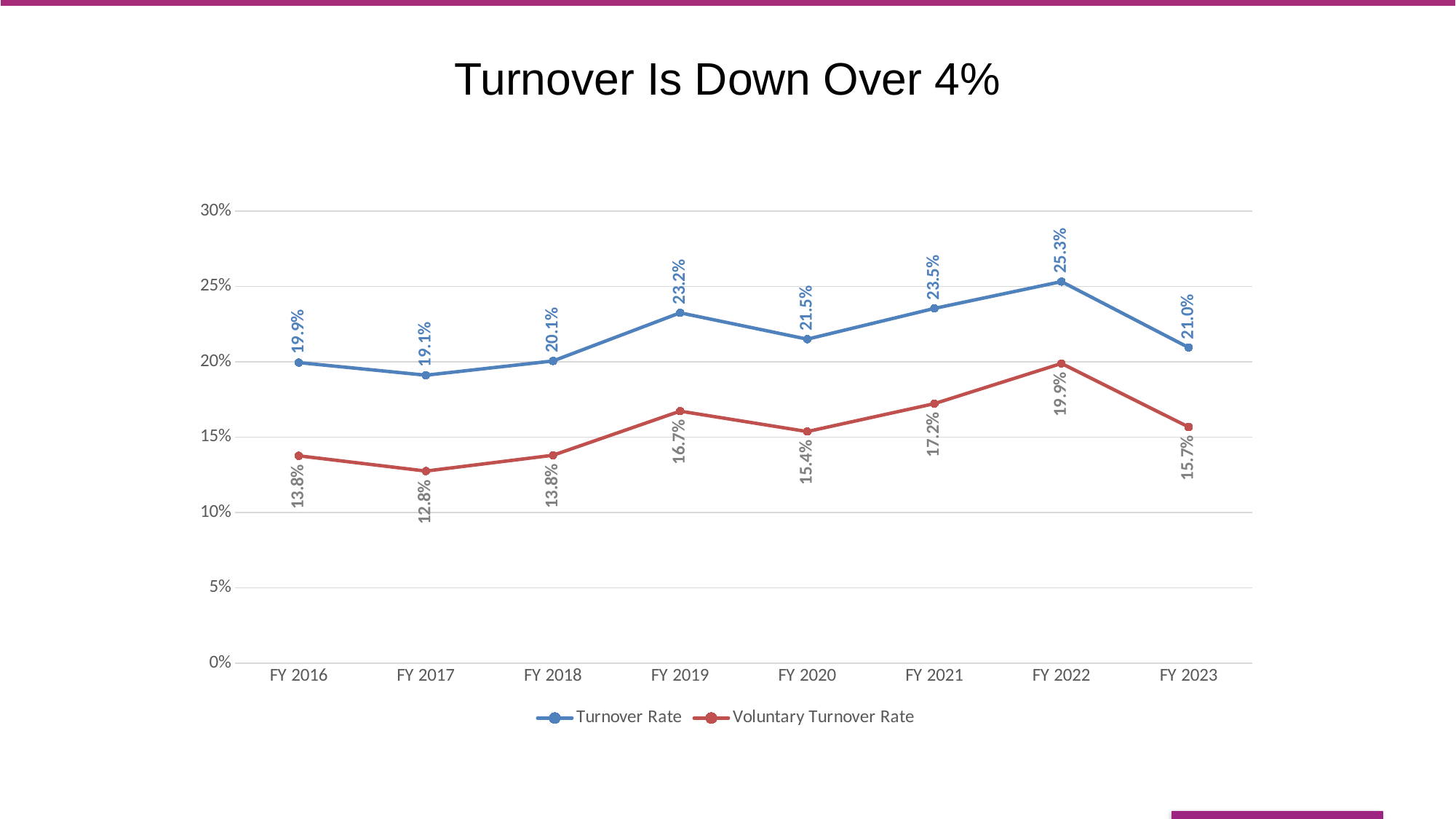
Which is larger: the Turnover Rate in FY 2019 or in FY 2020? FY 2019 Is the Voluntary Turnover Rate for FY 2022 greater or less than 15%? greater In which fiscal year is the Turnover Rate highest? FY 2022 How many series does the legend list? 2 What kind of chart is shown on the slide? line chart How many fiscal years are shown on the x axis? 8 What is the Turnover Rate for FY 2023? 21.0% What is the Turnover Rate for FY 2022? 25.3% What is the difference between the Turnover Rate in FY 2022 and FY 2023? 4.3% What is the title of the slide? Turnover Is Down Over 4% In which fiscal year is the Voluntary Turnover Rate lowest? FY 2017 What is the Voluntary Turnover Rate for FY 2017? 12.8%